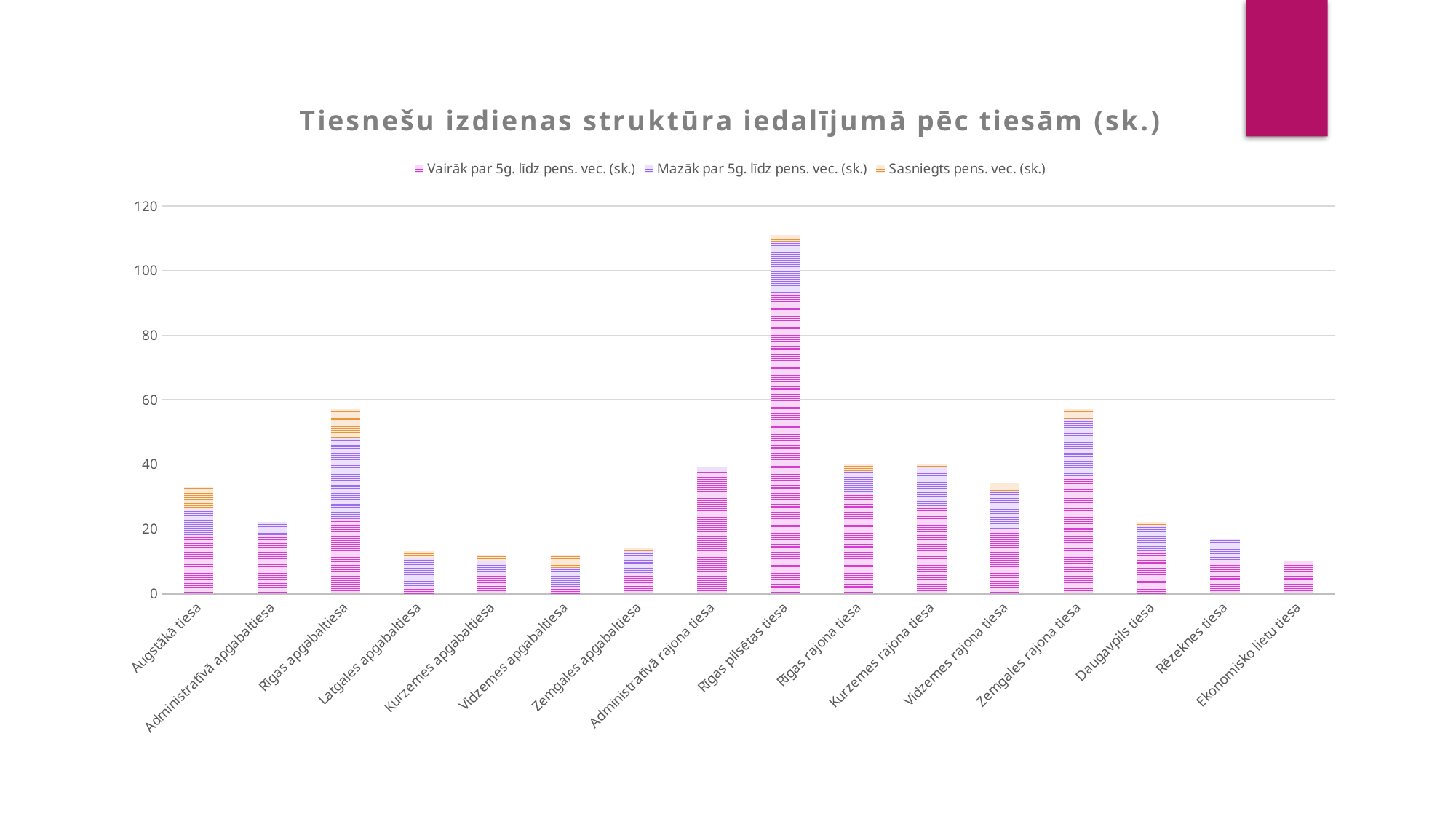
Is the total value for Rīgas pilsētas tiesa greater or less than 100? greater Is the total value for Rēzeknes tiesa greater or less than 20? less Which court has the highest total bar? Rīgas pilsētas tiesa Is the total value for Augstākā tiesa greater or less than 20? greater How many series does the legend list? 3 What is the title of the chart? Tiesnešu izdienas struktūra iedalījumā pēc tiesām (sk.) How many courts (categories) are shown on the x axis? 16 Which has the larger total bar, Rīgas apgabaltiesa or Augstākā tiesa? Rīgas apgabaltiesa What kind of chart is shown on the slide? bar chart Which has the larger total bar, Administratīvā apgabaltiesa or Latgales apgabaltiesa? Administratīvā apgabaltiesa